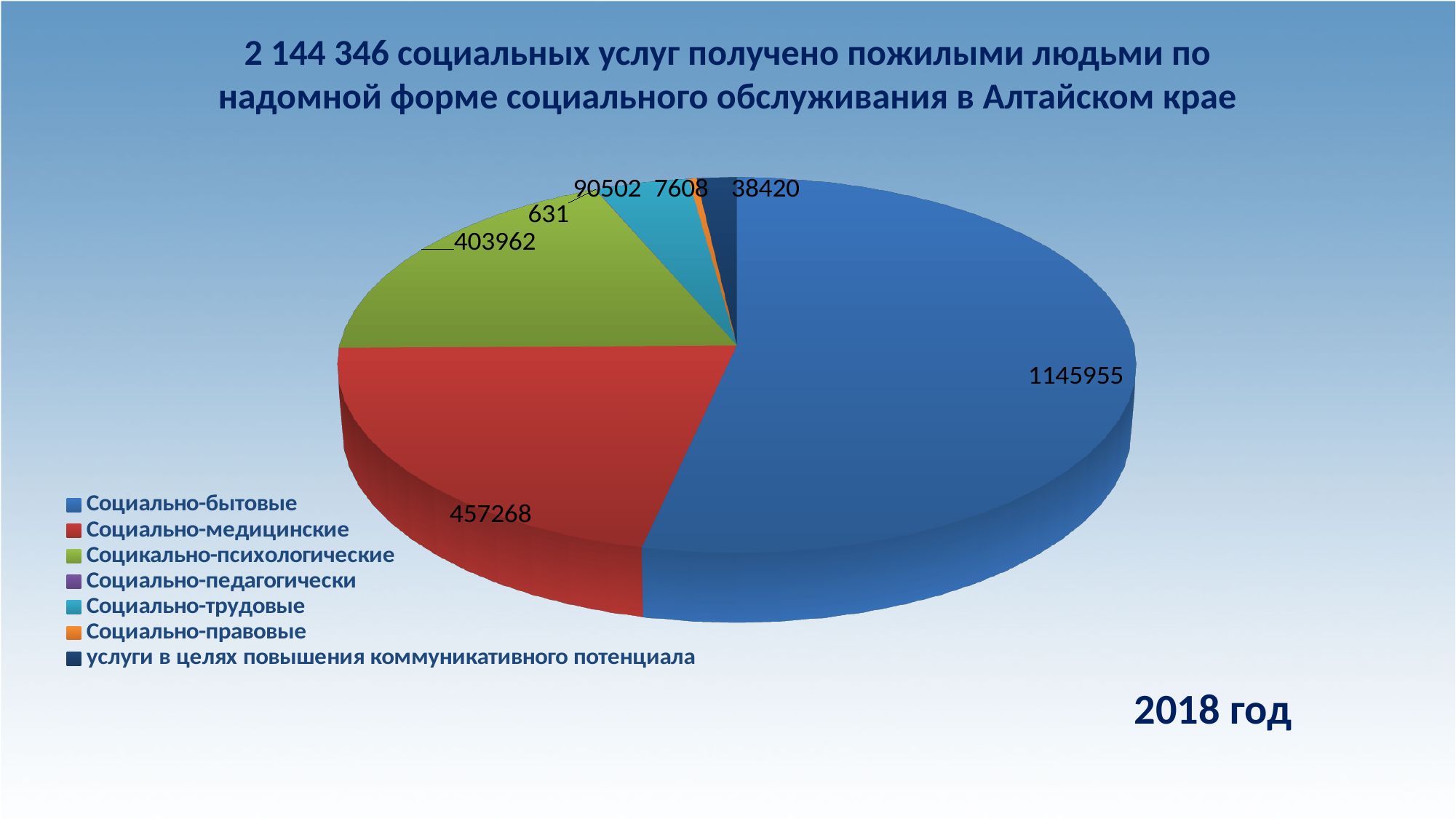
What year is indicated on the slide for the data? 2018 год What value is shown for the услуги в целях повышения коммуникативного потенциала slice? 38420 How many categories does the legend list? 7 What value is shown for the Социально-бытовые slice? 1145955 What value is shown for the Социально-медицинские slice? 457268 What value is shown for the Социально-трудовые slice? 90502 What is the difference between the Социально-бытовые value and the Социально-медицинские value? 688687 What value is shown for the Социкально-психологические slice? 403962 What kind of chart is shown on the slide? Pie chart Which is larger: Социально-трудовые or Социально-правовые? Социально-трудовые Which category has the largest slice of the pie? Социально-бытовые Which category has the smallest value in the pie? Социально-педагогически